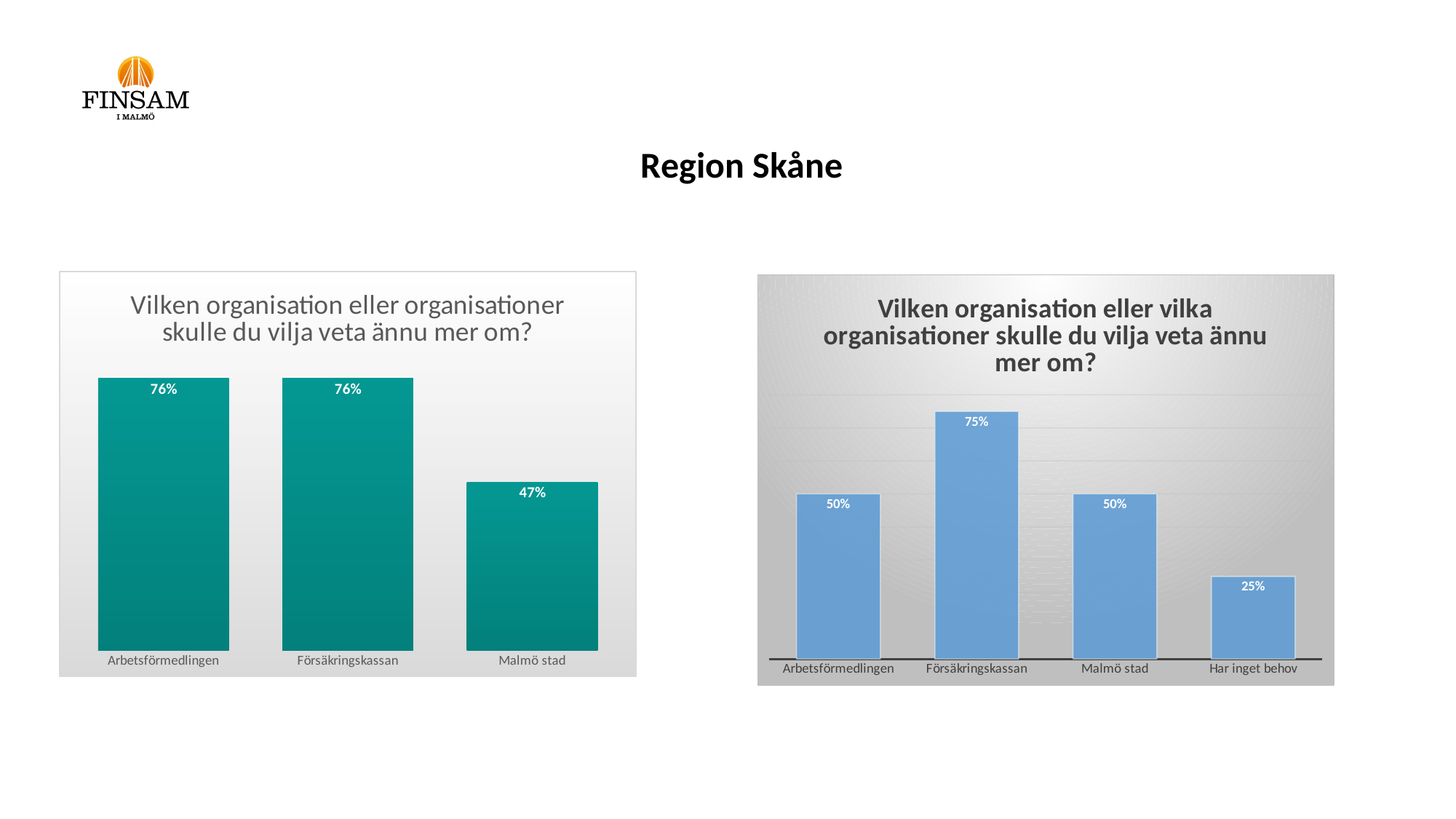
In the left chart, what is the value for Arbetsförmedlingen? 76% In the right chart, what is the value for Försäkringskassan? 75% In the right chart, what is the value for Har inget behov? 25% In the left chart, what is the value for Malmö stad? 47% In the right chart, which category has the highest value? Försäkringskassan In the left chart, which category has the lowest value? Malmö stad In the left chart, what is the difference between Försäkringskassan and Malmö stad? 29% In the left chart, how many categories are shown? 3 In the right chart, how many categories are shown? 4 What kind of chart is the right chart? Bar chart In the right chart, what is the difference between Försäkringskassan and Har inget behov? 50% In the right chart, which category has the lowest value? Har inget behov